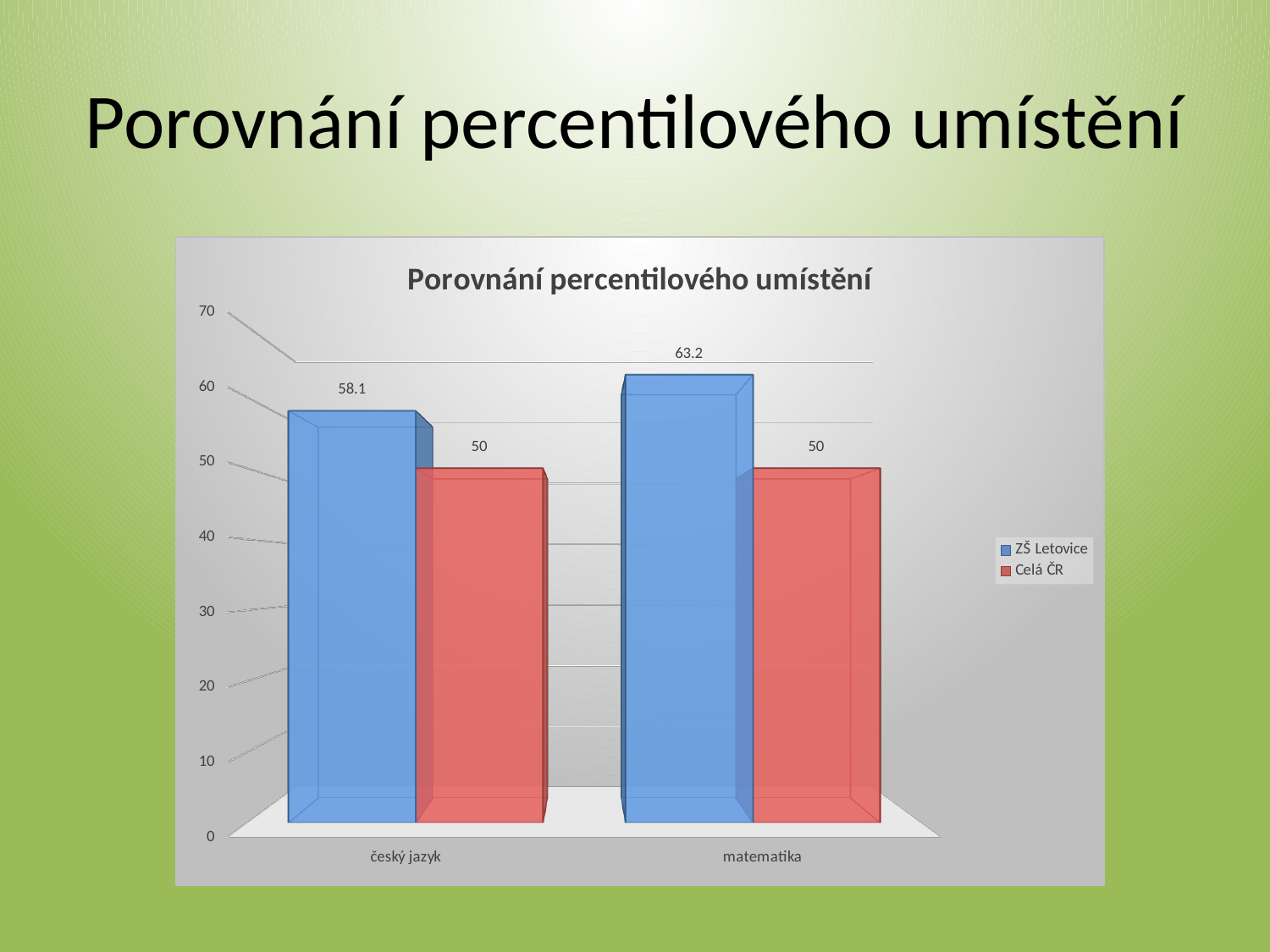
How many categories are shown on the x axis? 2 In which subject does ZŠ Letovice have the higher value? matematika How many series does the legend list? 2 What kind of chart is shown? bar chart What is the difference between ZŠ Letovice and Celá ČR in český jazyk? 8.1 What is the title of the chart? Porovnání percentilového umístění What is the difference between ZŠ Letovice and Celá ČR in matematika? 13.2 What is the value for Celá ČR in matematika? 50 Is the value for ZŠ Letovice in matematika greater or less than 60? greater Which is larger in český jazyk: ZŠ Letovice or Celá ČR? ZŠ Letovice What is the value for ZŠ Letovice in matematika? 63.2 What is the value for ZŠ Letovice in český jazyk? 58.1